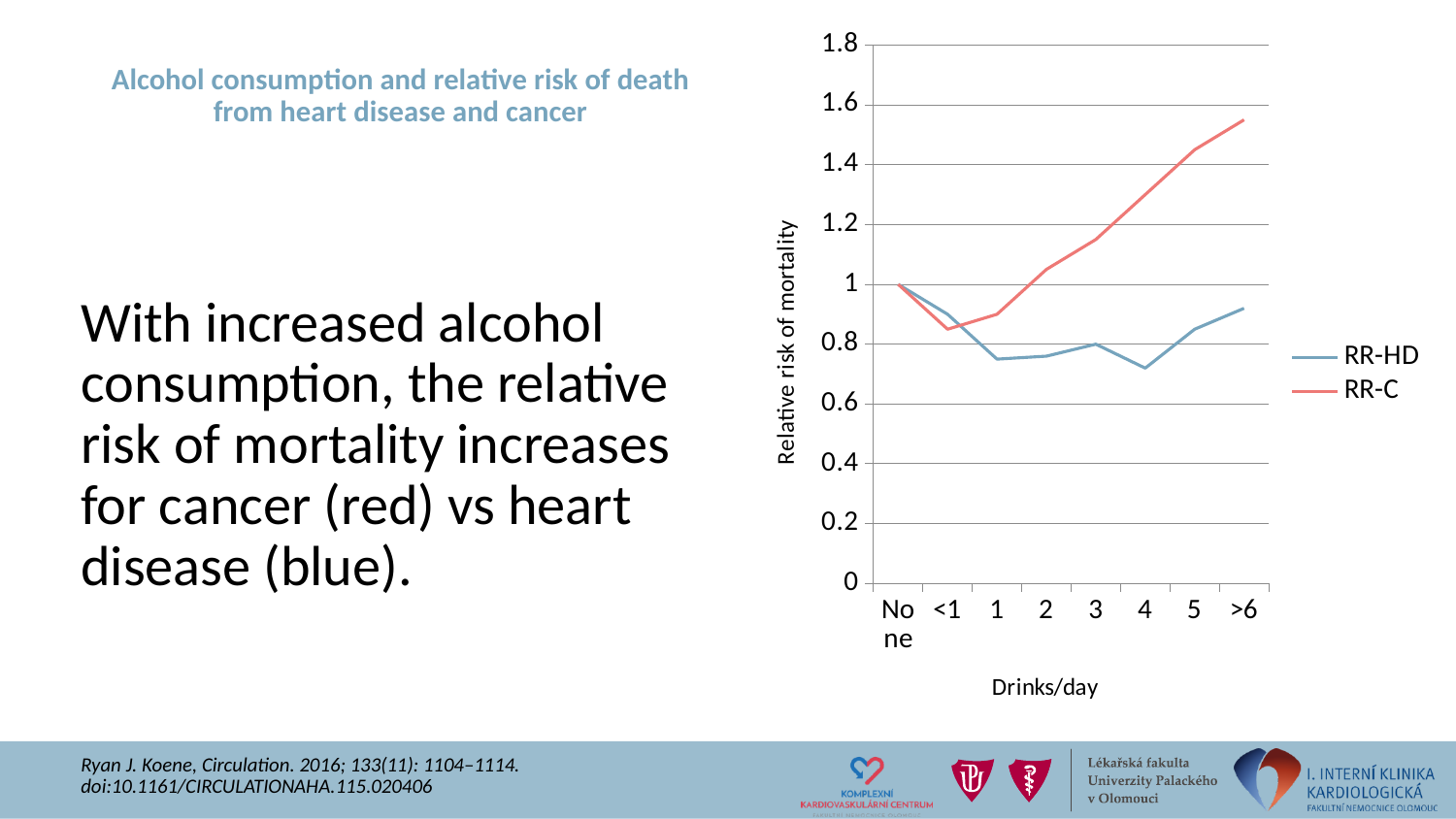
How many categories are shown on the x axis? 8 What is the value of RR-HD for the 'None' category? 1 Is the RR-C value for 3 greater or less than 1? greater What is the value of RR-C for the 'None' category? 1 Which category has the highest RR-C value? >6 Is the RR-C value for >6 greater or less than 1.4? greater How many series does the legend list? 2 What kind of chart is shown on the slide? line chart At 1 drink/day, which series has the larger value, RR-HD or RR-C? RR-C Which category has the lowest RR-C value? <1 Does the RR-C series rise or fall from 1 drink/day to >6 drinks/day? rise Is the RR-HD value for 4 greater or less than 0.8? less